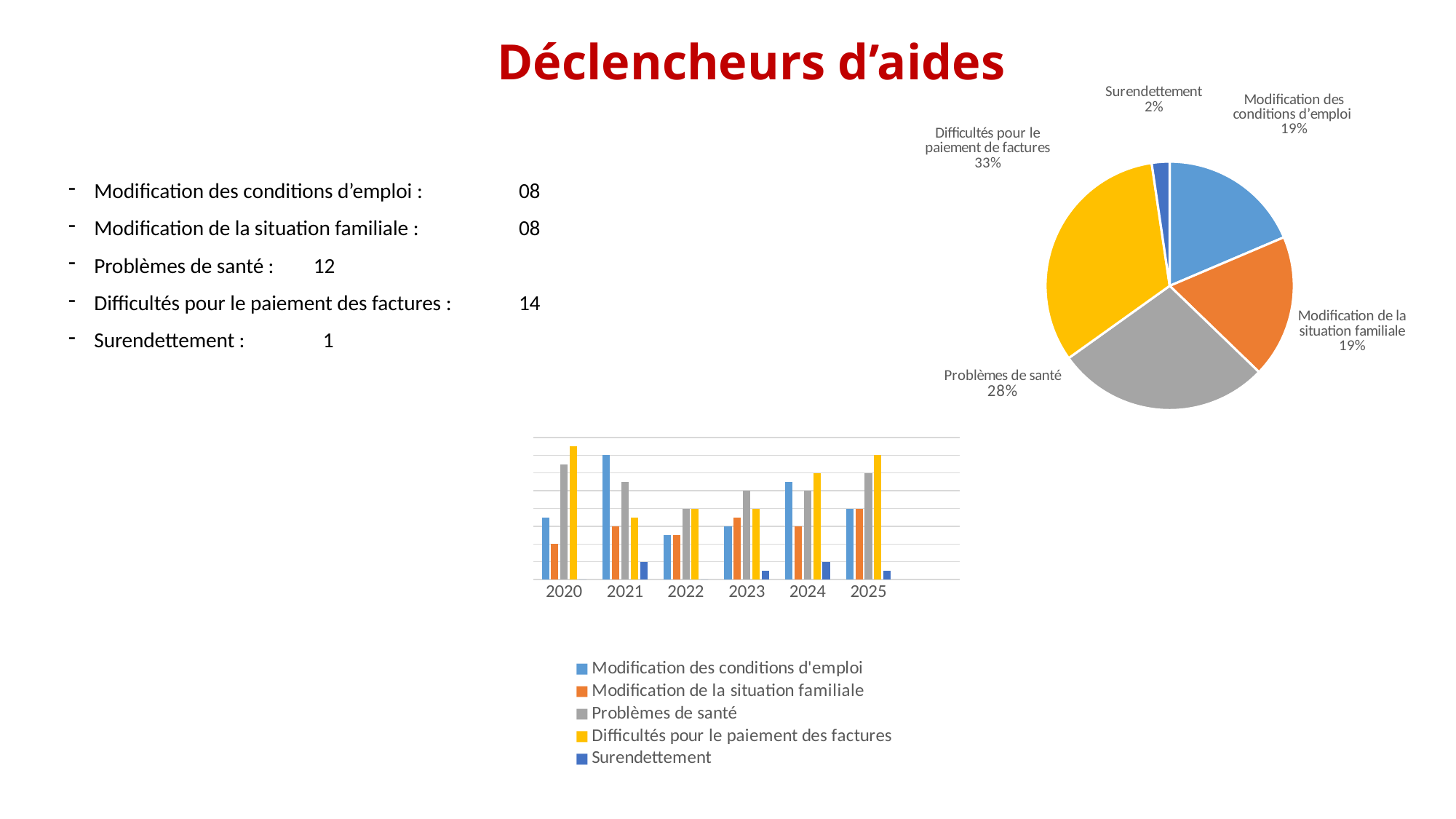
In the pie chart, what share does Surendettement have? 2% In the pie chart, what share does Difficultés pour le paiement des factures have? 33% How many slices does the pie chart have? 5 In the bar chart, which is larger for 2024: Difficultés pour le paiement des factures or Modification de la situation familiale? Difficultés pour le paiement des factures In the pie chart, which category has the smallest slice? Surendettement How many series does the legend of the bar chart list? 5 In the pie chart, what share does Problèmes de santé have? 28% In the pie chart, which category has the largest slice? Difficultés pour le paiement des factures What kind of chart is the chart at the bottom of the slide with years on the x axis? bar chart In the pie chart, what is the difference in percentage points between Difficultés pour le paiement des factures and Problèmes de santé? 5 What kind of chart is the chart in the top right of the slide? pie chart In the bar chart, which series has the tallest bar for 2021? Modification des conditions d'emploi